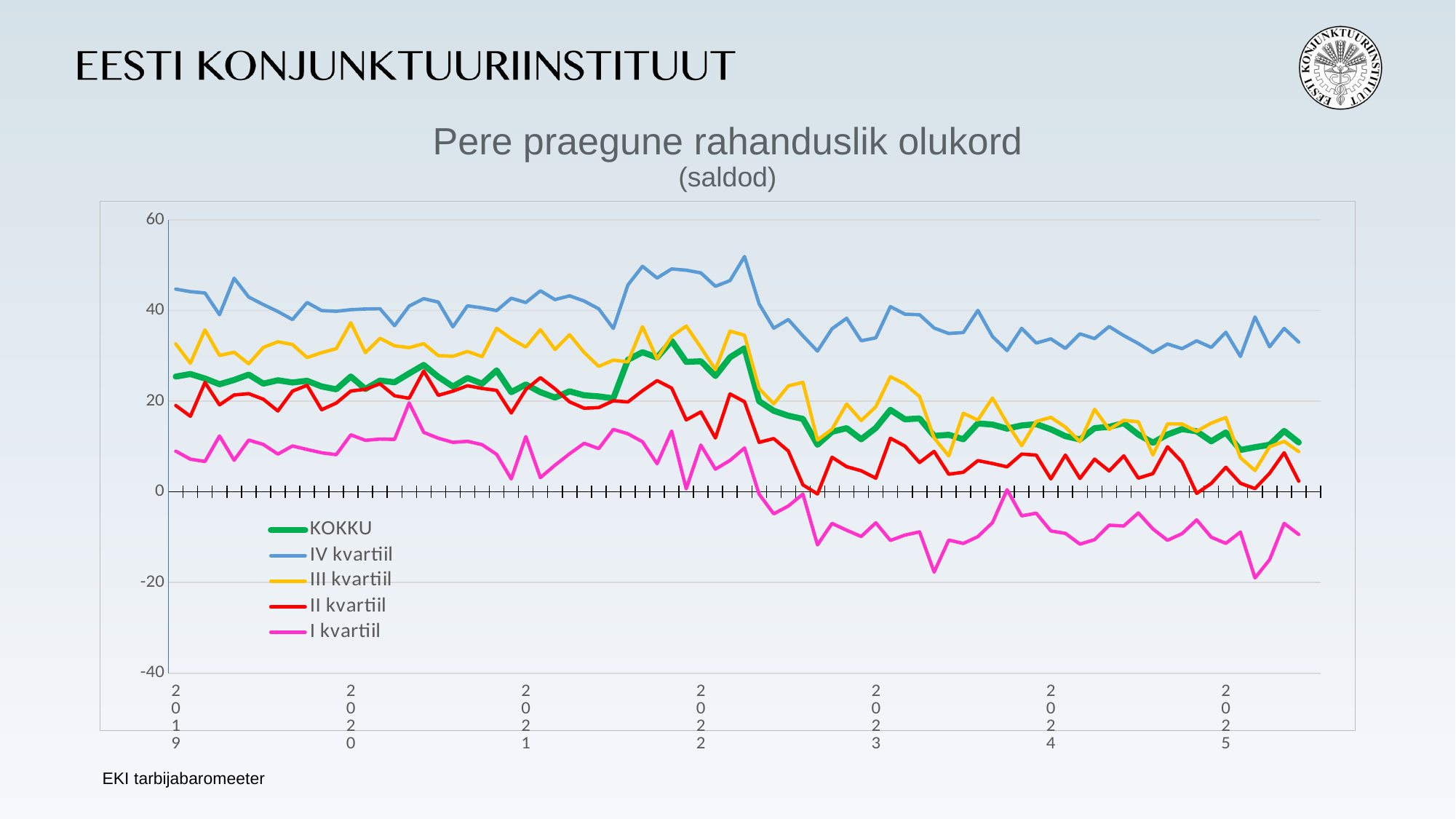
Which series has the lowest values across the whole period? I kvartiil Does the KOKKU line rise or fall from 2022 to 2025? fall Is the lowest value for I kvartiil in 2025 greater or less than -10? less How many series does the legend list? 5 At the start of 2019, which is higher: III kvartiil or II kvartiil? III kvartiil What is the title of the chart? Pere praegune rahanduslik olukord (saldod) Which series has the highest values across the whole period? IV kvartiil Is the value for IV kvartiil at the start of 2019 greater or less than 40? greater What kind of chart is shown on the slide? line chart Is the value for KOKKU at the start of 2019 greater or less than 20? greater How many years are labelled on the x axis? 7 What colour is the KOKKU line? green